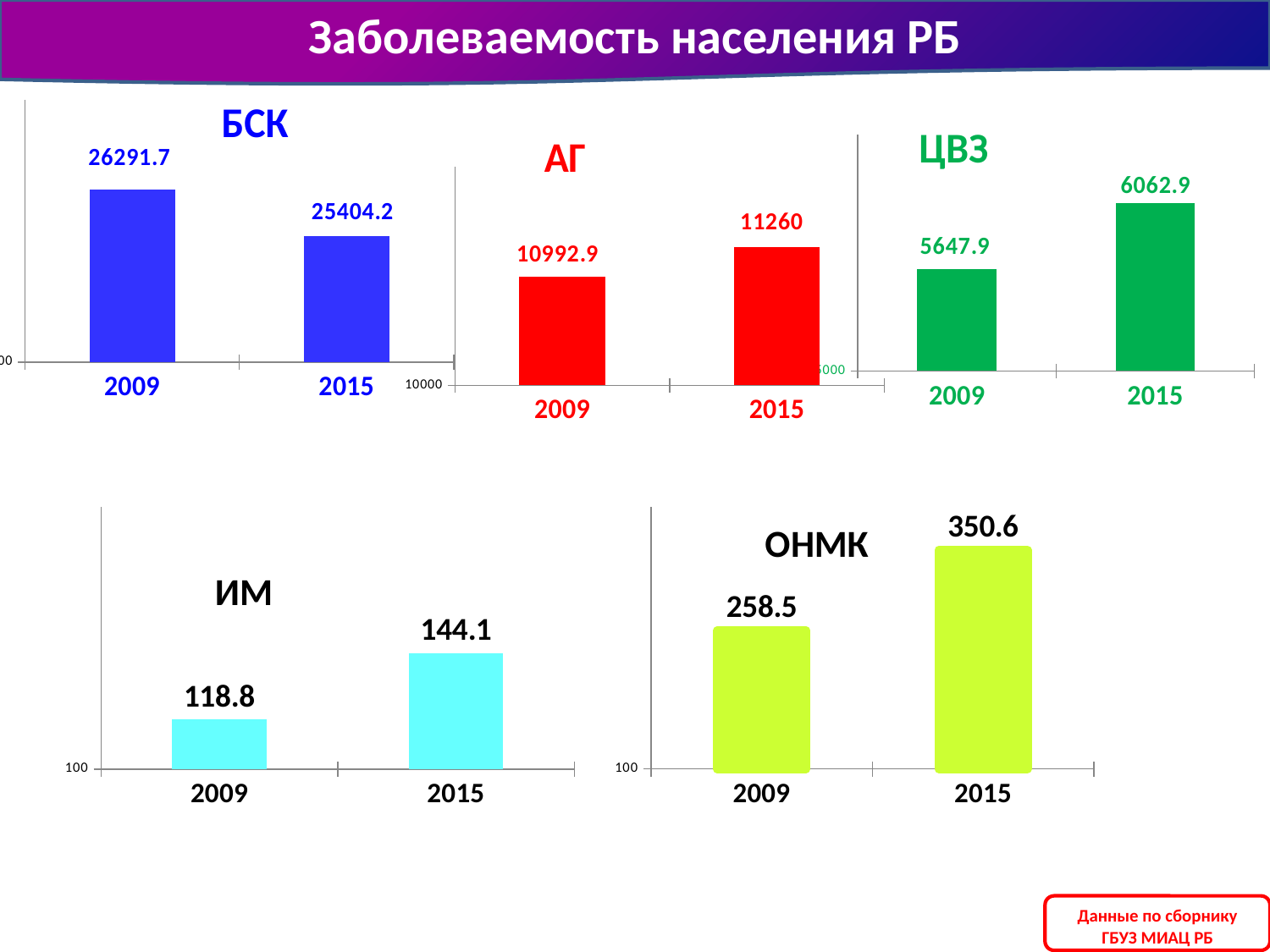
In the ИМ chart, which year has the higher value, 2009 or 2015? 2015 In the БСК chart, what is the value for 2009? 26291.7 In the ОНМК chart, what is the value for 2009? 258.5 How many bars are shown in the ЦВЗ chart? 2 In the БСК chart, what is the value for 2015? 25404.2 In the БСК chart, do the values rise or fall from 2009 to 2015? fall In the ИМ chart, what is the value for 2015? 144.1 In the АГ chart, what is the value for 2015? 11260 In the ЦВЗ chart, what is the value for 2009? 5647.9 What type of chart is the ОНМК chart? bar chart In the ОНМК chart, do the values rise or fall from 2009 to 2015? rise In the АГ chart, what is the difference between the 2015 and 2009 values? 267.1